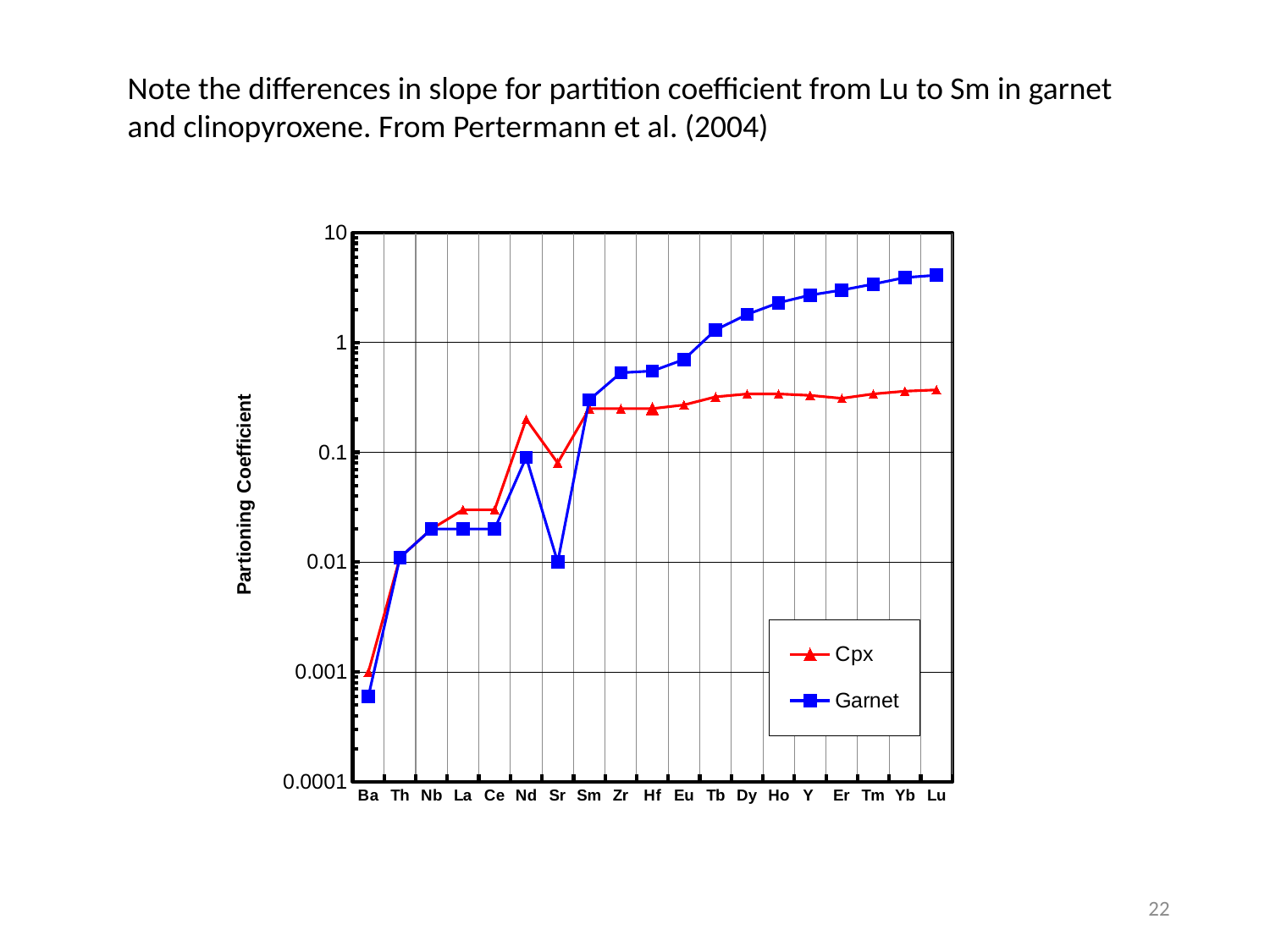
Is the Cpx value for Nd greater or less than 0.1? greater What kind of chart is shown on the slide? line chart At Lu, which series has the larger partition coefficient, Cpx or Garnet? Garnet Is the Garnet value for Sr greater or less than 0.1? less For which element is the Garnet partition coefficient highest? Lu Which series are listed in the legend? Cpx and Garnet How many series does the legend list? 2 How many elements are plotted along the x axis? 19 At Sr, which series has the larger partition coefficient, Cpx or Garnet? Cpx What is the title of the y axis? Partioning Coefficient Is the Cpx value for Lu greater or less than 1? less